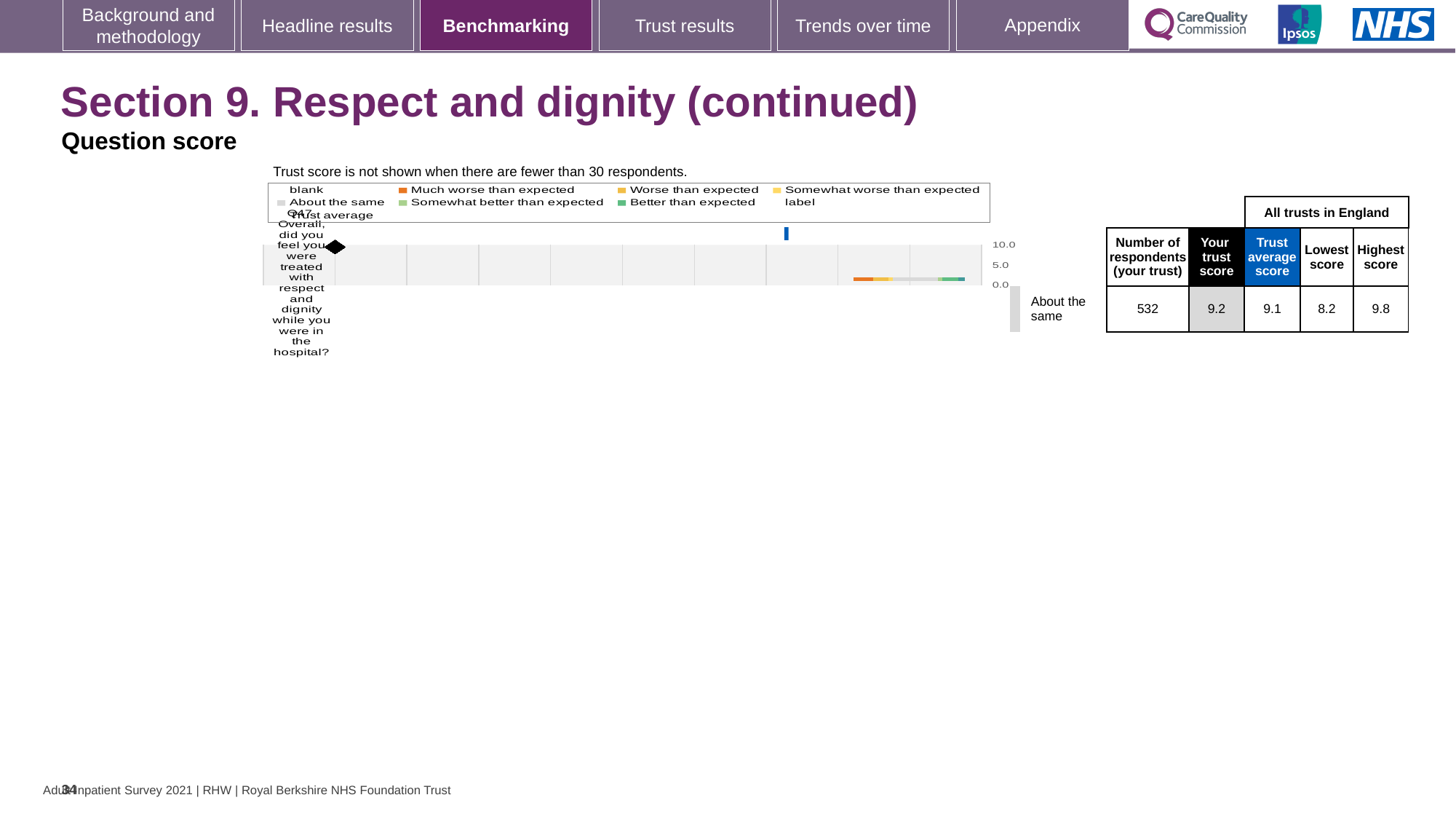
How many questions are plotted on the chart? 1 What is the 'Your trust score' for Q47 shown next to the chart? 9.2 What is the trust average score for Q47? 9.1 Is the trust score for Q47 greater or less than 5.0 on the chart's axis? greater Which is larger for Q47: your trust score or the trust average score? your trust score What is the highest score across all trusts in England for Q47? 9.8 What is the difference between the highest score and the lowest score for Q47? 1.6 What kind of chart is shown on the slide? bar chart How many respondents from your trust answered Q47? 532 What benchmark category label is shown for Q47 on the chart? About the same What colour does the legend use for 'Much worse than expected'? orange What is the lowest score across all trusts in England for Q47? 8.2